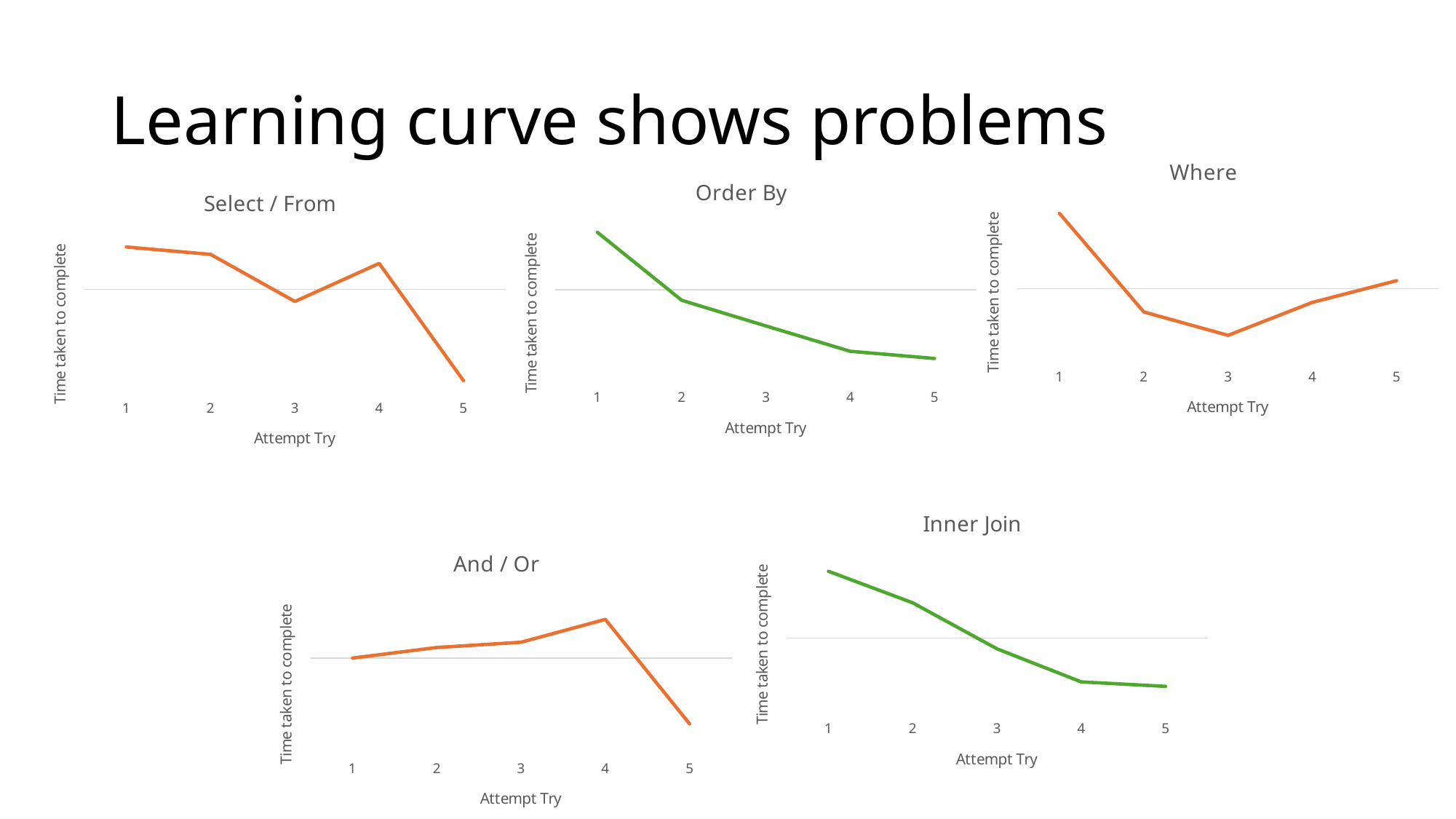
In the "Inner Join" chart, do the values rise or fall along the x axis? Fall In the "Select / From" chart, which attempt has the lowest time taken to complete? 5 What kind of chart is the "Select / From" chart? Line chart How many charts are shown on the slide? 5 In the "And / Or" chart, is the value for attempt 4 larger or smaller than the value for attempt 5? Larger In the "Order By" chart, which attempt has the highest time taken to complete? 1 In the "And / Or" chart, which attempt has the highest time taken to complete? 4 In the "Where" chart, which attempt has the highest time taken to complete? 1 In the "Select / From" chart, how many attempts are plotted on the x axis? 5 In the "Where" chart, which attempt has the lowest time taken to complete? 3 In the "Order By" chart, do the values rise or fall from attempt 1 to attempt 5? Fall Which charts on the slide use a green line? Order By and Inner Join